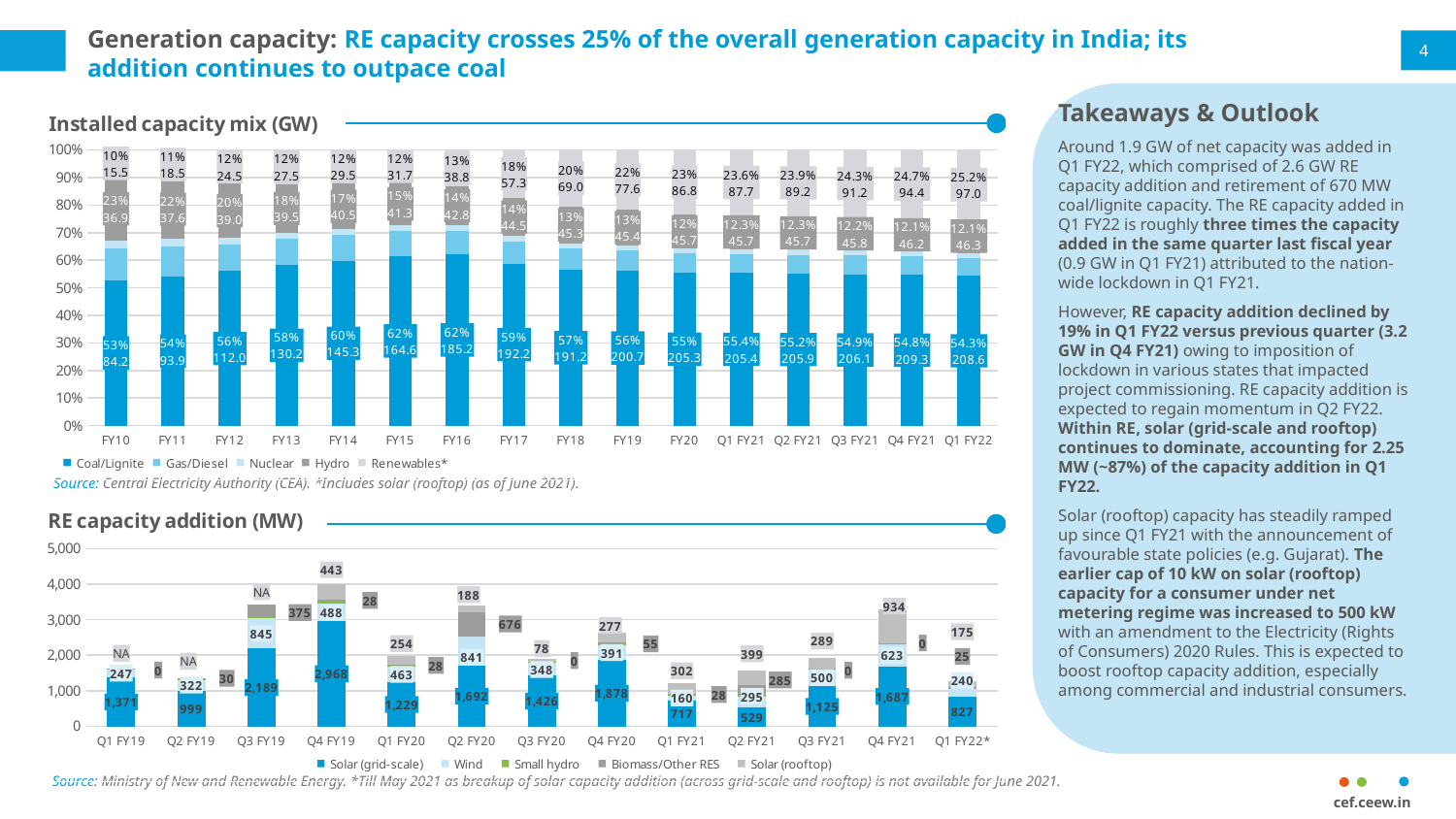
In the 'RE capacity addition (MW)' chart, what is the Solar (grid-scale) addition in Q4 FY19? 2,968 In the 'Installed capacity mix (GW)' chart, what is the Renewables capacity in Q1 FY22? 97.0 In the 'Installed capacity mix (GW)' chart, what share of installed capacity does Coal/Lignite account for in FY15? 62% How many series does the legend of the 'Installed capacity mix (GW)' chart list? 5 In the 'Installed capacity mix (GW)' chart, by how much did Renewables capacity increase from FY10 (15.5) to Q1 FY22 (97.0)? 81.5 How many quarters are shown on the x axis of the 'RE capacity addition (MW)' chart? 13 What kind of chart is the 'Installed capacity mix (GW)' chart? Stacked bar chart How many periods are shown on the x axis of the 'Installed capacity mix (GW)' chart? 16 In the 'RE capacity addition (MW)' chart, which quarter has the highest Solar (rooftop) addition? Q4 FY21 In the 'RE capacity addition (MW)' chart, which is larger: the Wind addition in Q3 FY19 or in Q4 FY21? Q3 FY19 In the 'Installed capacity mix (GW)' chart, what is the Hydro capacity in FY10? 36.9 In the 'Installed capacity mix (GW)' chart, does the Renewables share rise or fall from FY10 to Q1 FY22? Rise